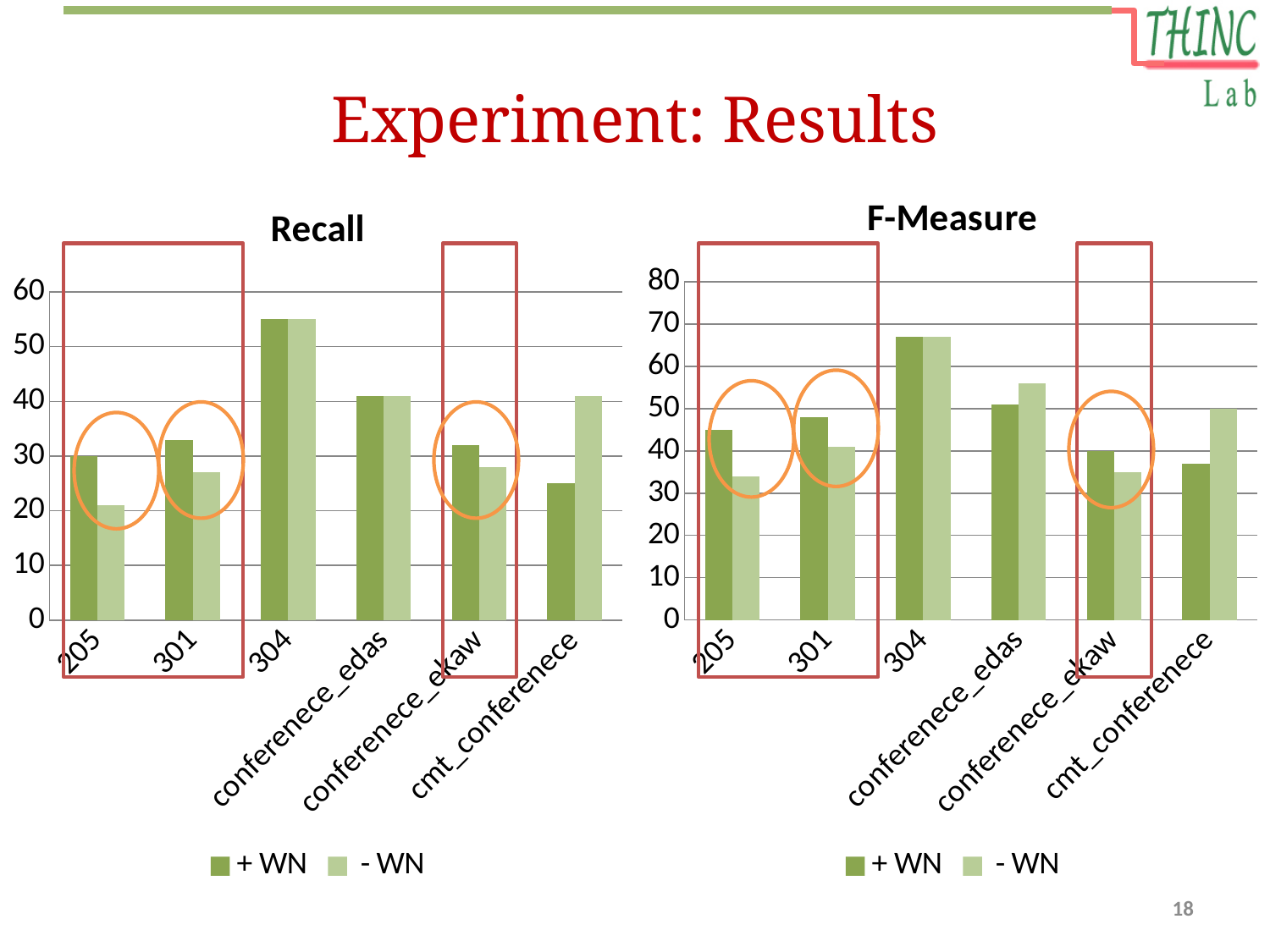
In the Recall chart, is the + WN value for 304 greater or less than 50? greater In the Recall chart, which category has the lowest - WN value? 205 In the Recall chart, is the - WN value for 205 greater or less than 30? less How many series does the legend of the Recall chart list? 2 In the Recall chart, which category has the highest + WN value? 304 How many categories are shown on the x axis of the F-Measure chart? 6 In the F-Measure chart, is the + WN value for 304 greater or less than 60? greater In the F-Measure chart, for 205, which series has the larger value, + WN or - WN? + WN In the Recall chart, for cmt_conferenece, which series has the larger value, + WN or - WN? - WN In the F-Measure chart, which category has the highest - WN value? 304